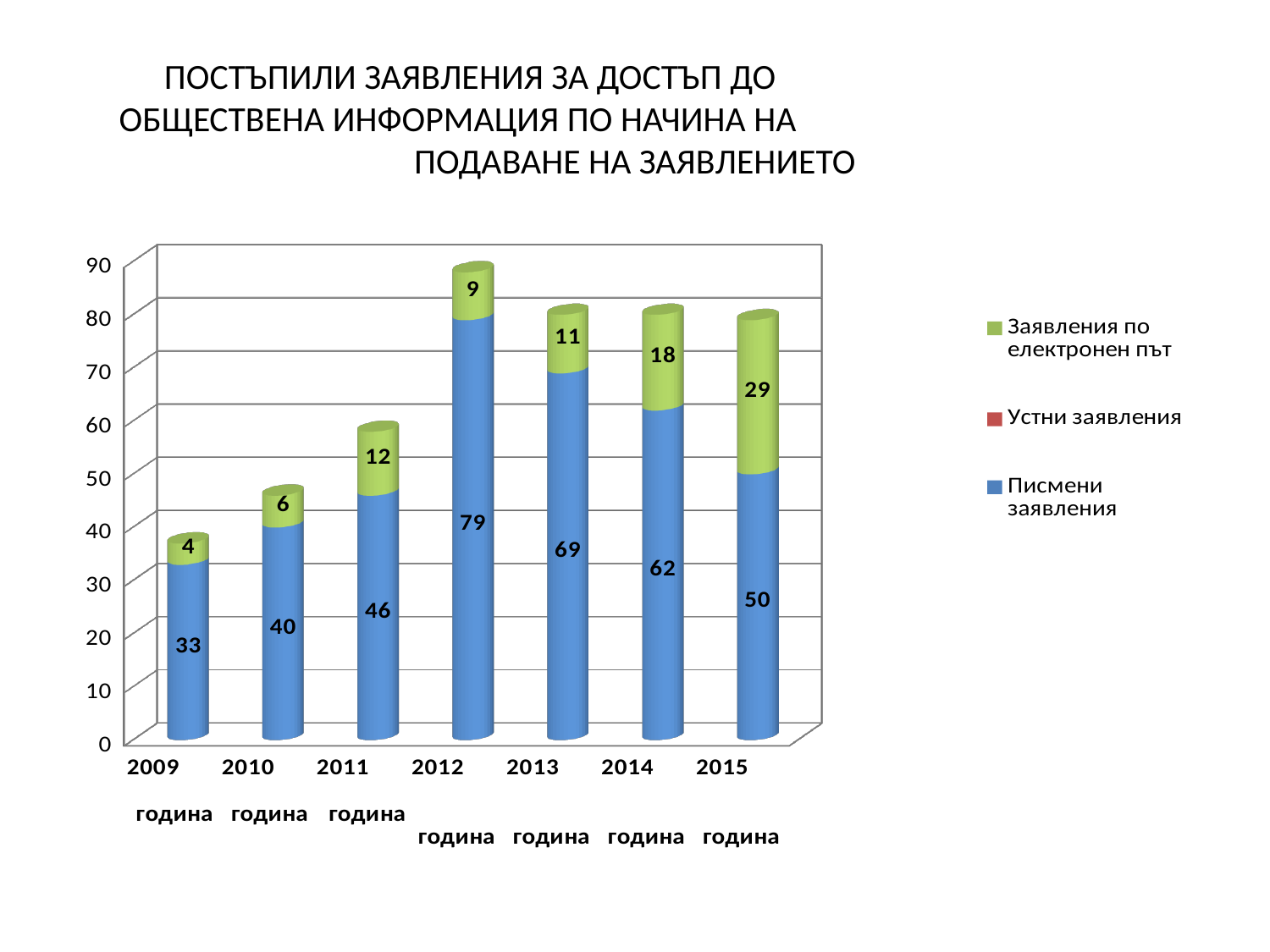
What is the value of Писмени заявления for 2009? 33 Which is larger: Заявления по електронен път in 2014 or in 2013? 2014 What is the value of Писмени заявления for 2012? 79 What is the total of the stacked bar for 2011? 58 Do the values for Заявления по електронен път rise or fall from 2012 to 2015? rise What is the value of Заявления по електронен път for 2015? 29 How many series does the legend list? 3 Which year has the lowest value for Заявления по електронен път? 2009 What is the difference between Писмени заявления in 2012 and in 2015? 29 What type of chart is shown on the slide? stacked bar chart How many years are shown on the x axis? 7 Which year has the highest value for Писмени заявления? 2012